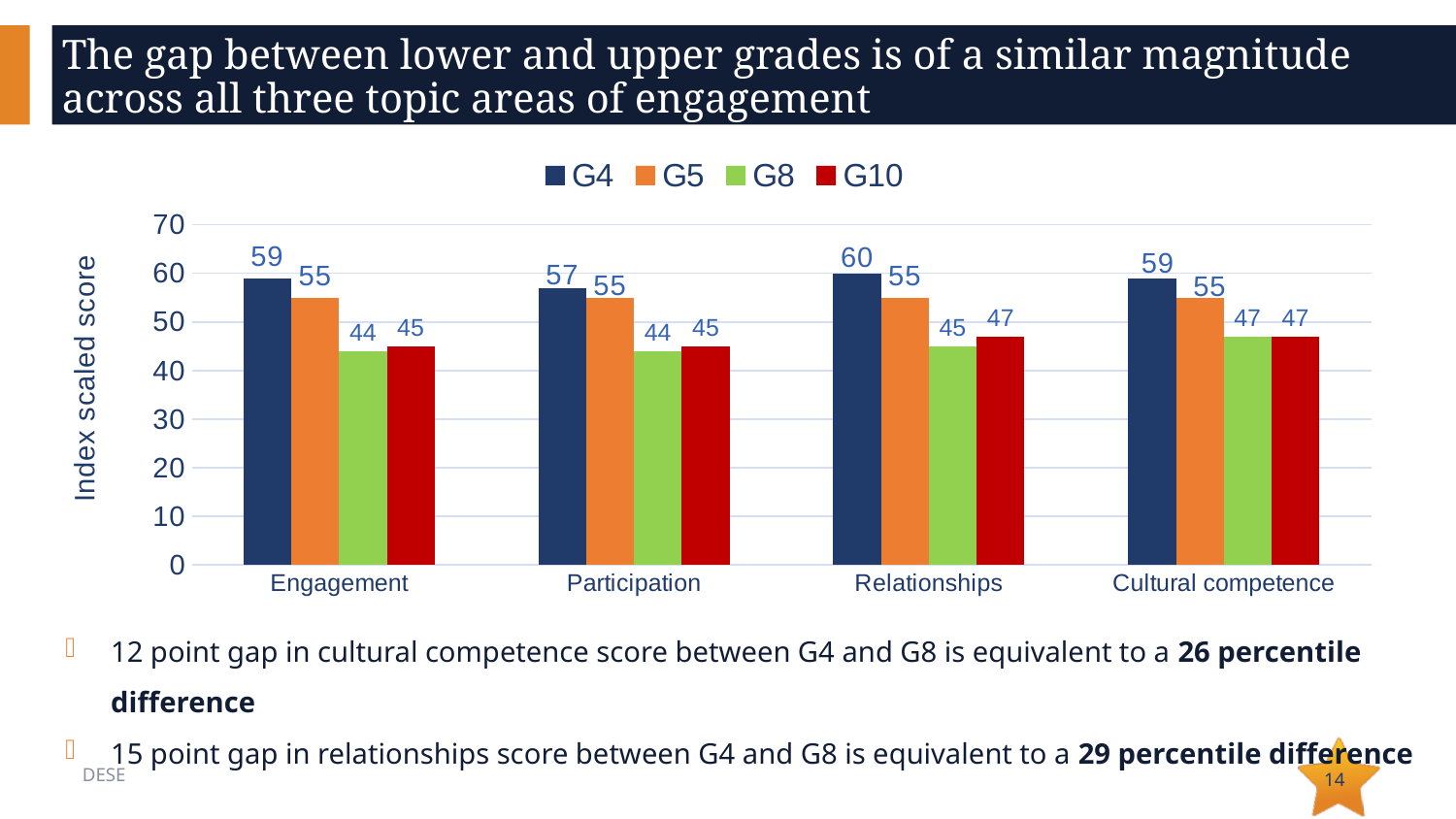
What kind of chart is shown on the slide? Bar chart Which is larger for Participation, the G4 value or the G10 value? G4 Which category has the highest G4 value? Relationships Which category has the lowest G8 value? Engagement and Participation (both 44) How many series does the legend list? 4 What is the G4 value for Relationships? 60 What is the difference between the G4 and G8 values for Relationships? 15 What is the G10 value for Engagement? 45 What is the difference between the G4 and G8 values for Cultural competence? 12 What is the G8 value for Cultural competence? 47 How many categories are shown on the x axis? 4 What is the label of the y axis? Index scaled score